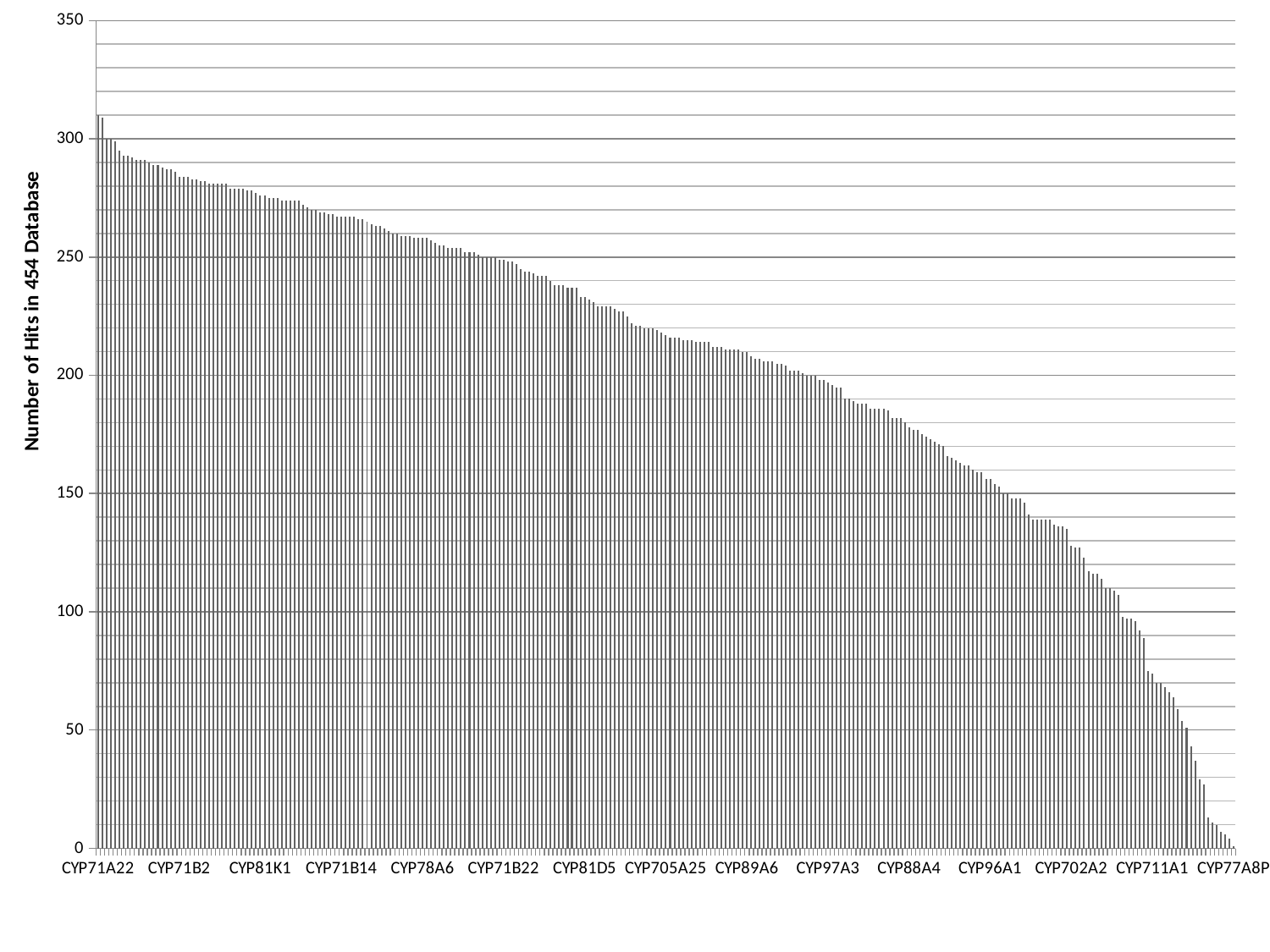
Is the value for CYP71A22 greater or less than 300? greater Is the value for CYP702A2 greater or less than 150? less Which labelled category has the lowest number of hits? CYP77A8P Do the values rise or fall moving from left to right along the x axis? fall Which labelled category has the highest number of hits? CYP71A22 Is the value for CYP81D5 greater or less than 250? less What is the title of the vertical axis? Number of Hits in 454 Database Which has more hits, CYP71B2 or CYP711A1? CYP71B2 What kind of chart is shown on the slide? bar chart